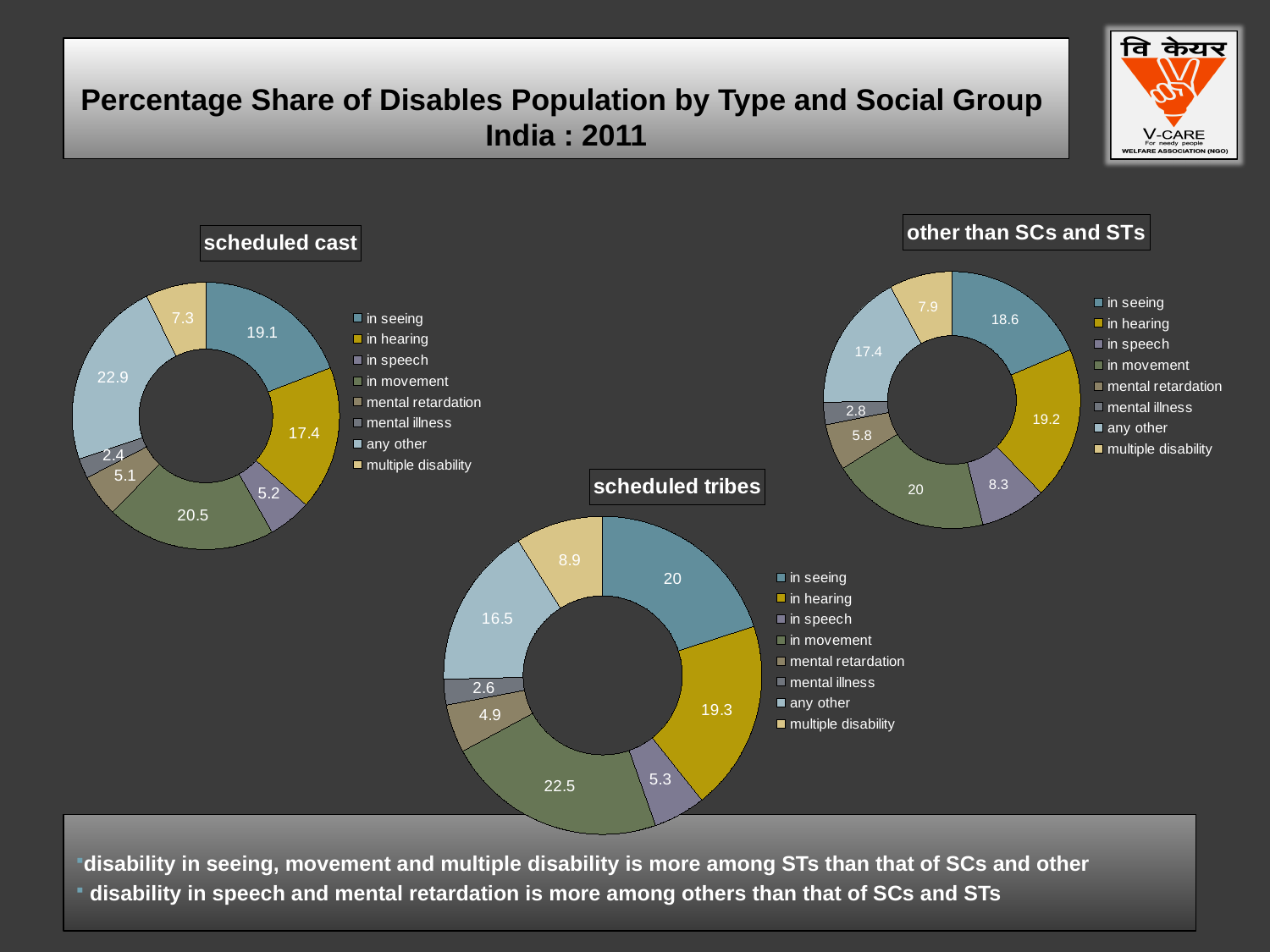
In the scheduled tribes chart, what is the value for in hearing? 19.3 In the other than SCs and STs chart, what is the difference between the values for in hearing and in seeing? 0.6 In the scheduled cast chart, what is the value for in movement? 20.5 In the scheduled cast chart, which category has the largest share? any other In the scheduled tribes chart, which category has the smallest share? mental illness How many categories does the scheduled tribes chart show? 8 In the scheduled tribes chart, what is the difference between the values for in movement and any other? 6 In the other than SCs and STs chart, what is the value for in speech? 8.3 How many charts are shown on the slide? 3 What kind of chart is the other than SCs and STs chart? doughnut (pie) chart In the other than SCs and STs chart, which category has the largest share? in movement In the scheduled cast chart, which is larger, in seeing or in hearing? in seeing